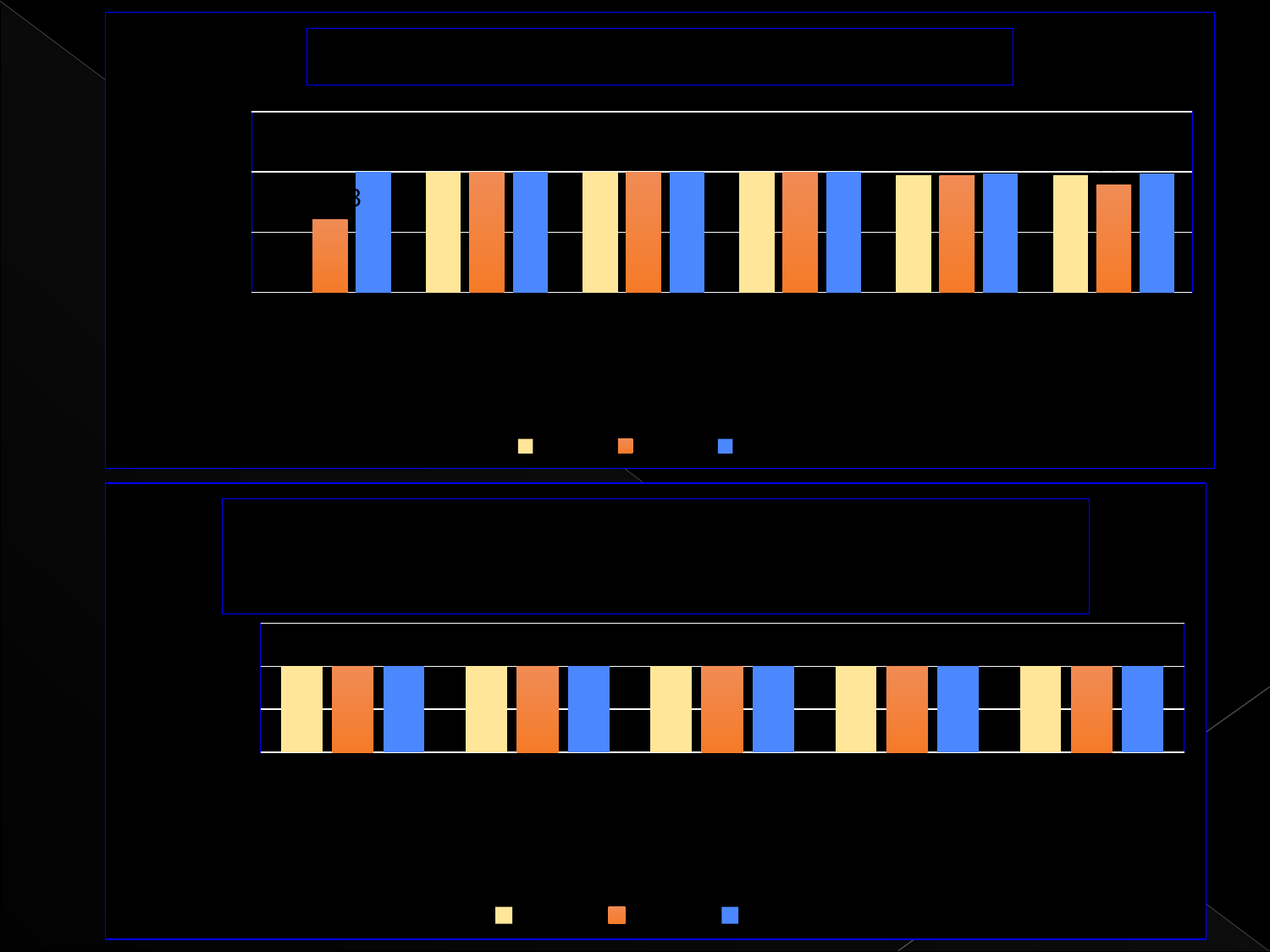
In the top chart, in the leftmost category group, is the orange bar or the blue bar taller? blue How many category groups of bars are plotted in the bottom chart? 5 How many series does the legend of the bottom chart list? 3 What colours are used for the three series in the bottom chart? yellow, orange and blue What kind of chart is the bottom chart on the slide? bar chart What kind of chart is the top chart on the slide? bar chart Are the bars in the bottom chart vertical or horizontal? vertical How many category groups of bars are plotted in the top chart? 6 How many series does the legend of the top chart list? 3 In the top chart, in the rightmost category group, is the orange bar or the blue bar taller? blue